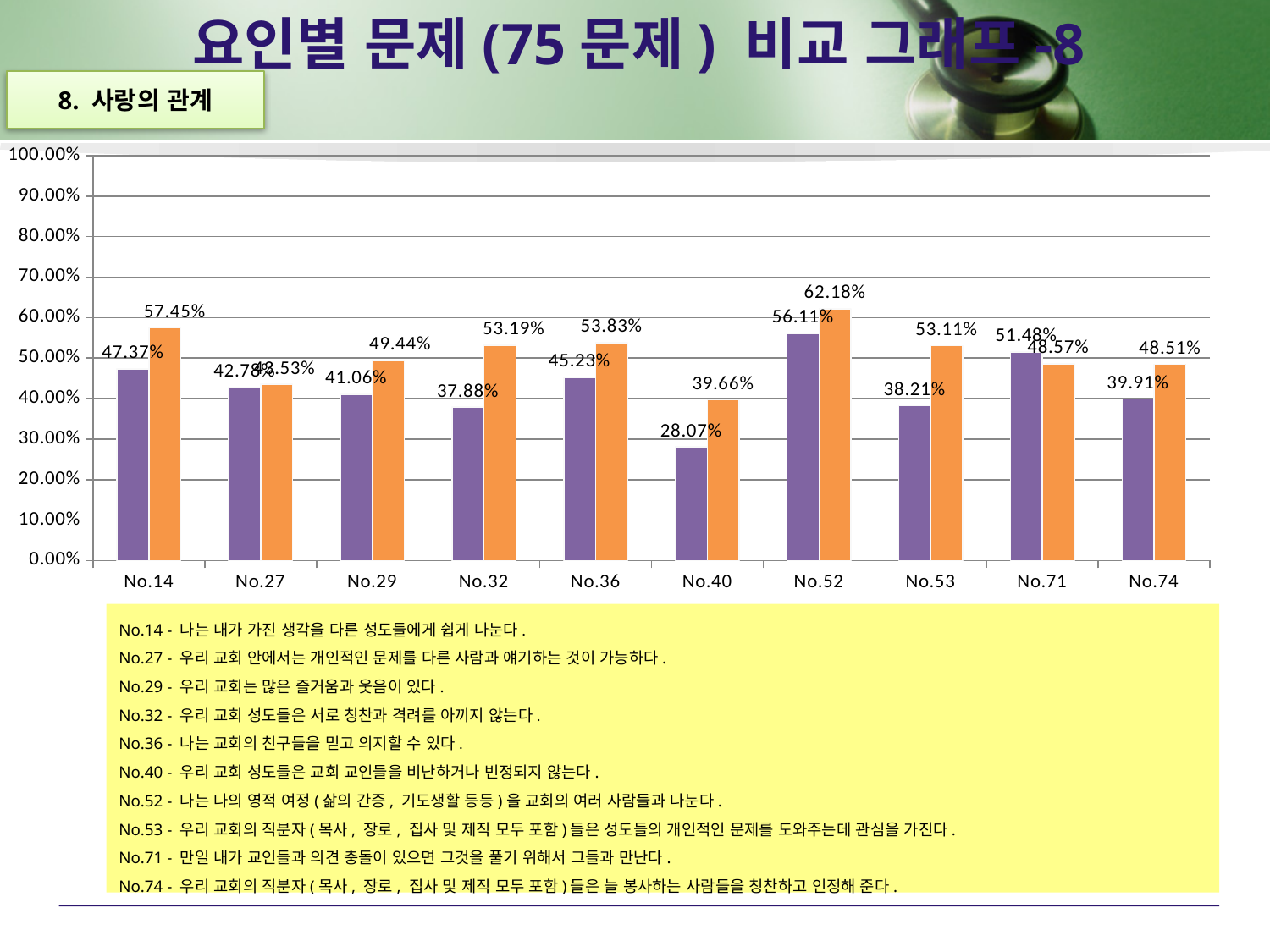
What kind of chart is shown on the slide? bar chart What is the value of the orange bar for No.32? 53.19% Which category has the highest orange bar? No.52 Which category has the lowest purple bar? No.40 How many categories are shown on the x axis? 10 What is the difference between the orange and purple bars for No.40? 11.59% What is the difference between the orange and purple bars for No.52? 6.07% What is the value of the purple bar for No.40? 28.07% Is the value of the purple bar for No.32 greater or less than 40.00%? less What is the value of the purple bar for No.71? 51.48% For No.71, which bar is larger, the purple or the orange? purple What is the value of the orange bar for No.52? 62.18%